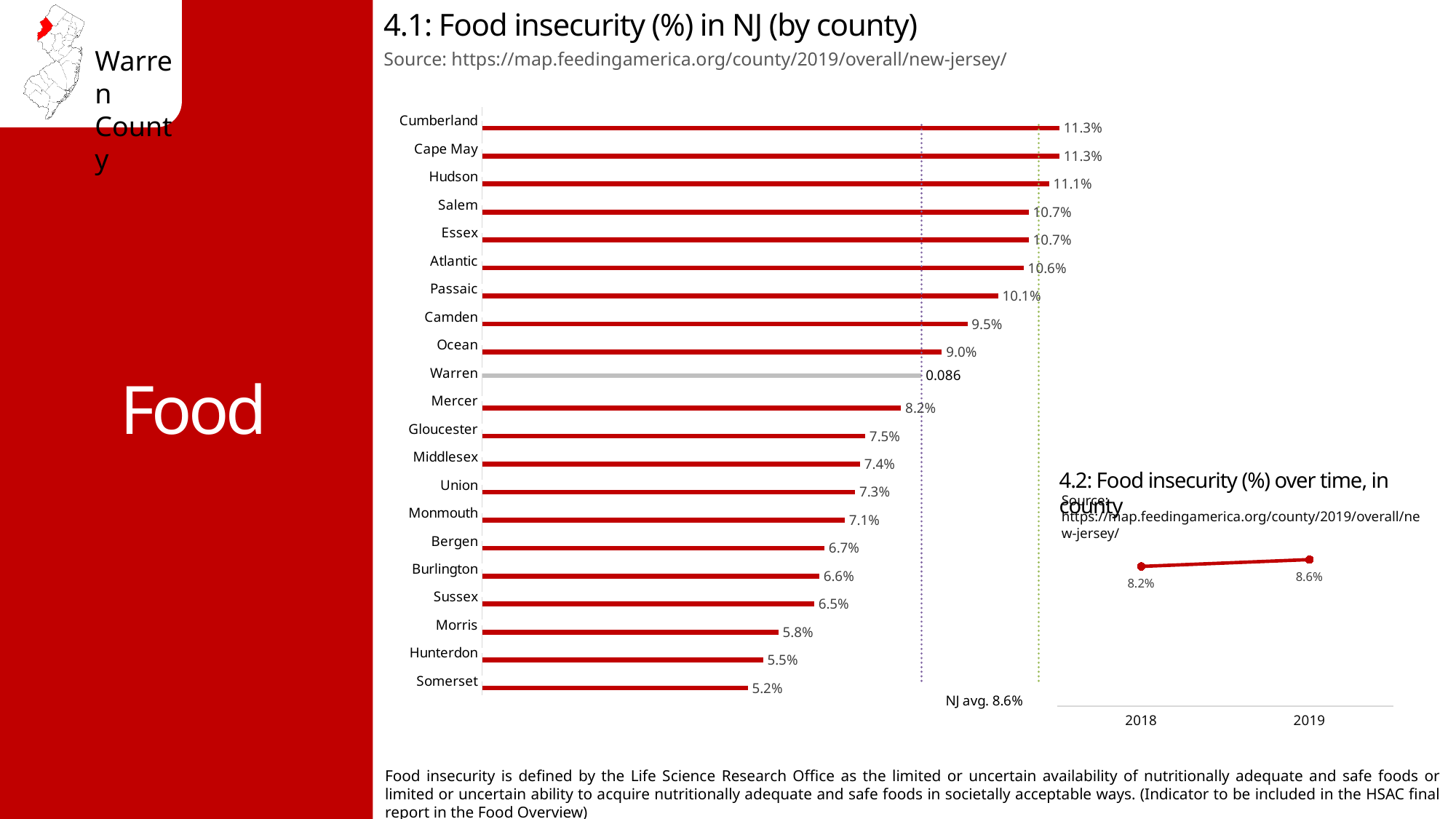
In chart 4.1, how many counties are listed? 21 In chart 4.2, what is the difference between the 2019 and 2018 values? 0.4% In chart 4.2, what is the value shown for 2019? 8.6% In chart 4.1, which has a higher value, Camden or Mercer? Camden What kind of chart is chart 4.1? Bar chart In chart 4.1, what is the food insecurity value shown for Hudson? 11.1% In chart 4.1, which county has the lowest food insecurity value? Somerset In chart 4.2, does the value rise or fall from 2018 to 2019? Rise In chart 4.1, what is the difference between the values for Cumberland and Somerset? 6.1% In chart 4.1, what NJ average value is labelled on the chart? 8.6% In chart 4.1, what is the food insecurity value for Passaic? 10.1% In chart 4.1, what value is printed next to the Warren bar? 0.086